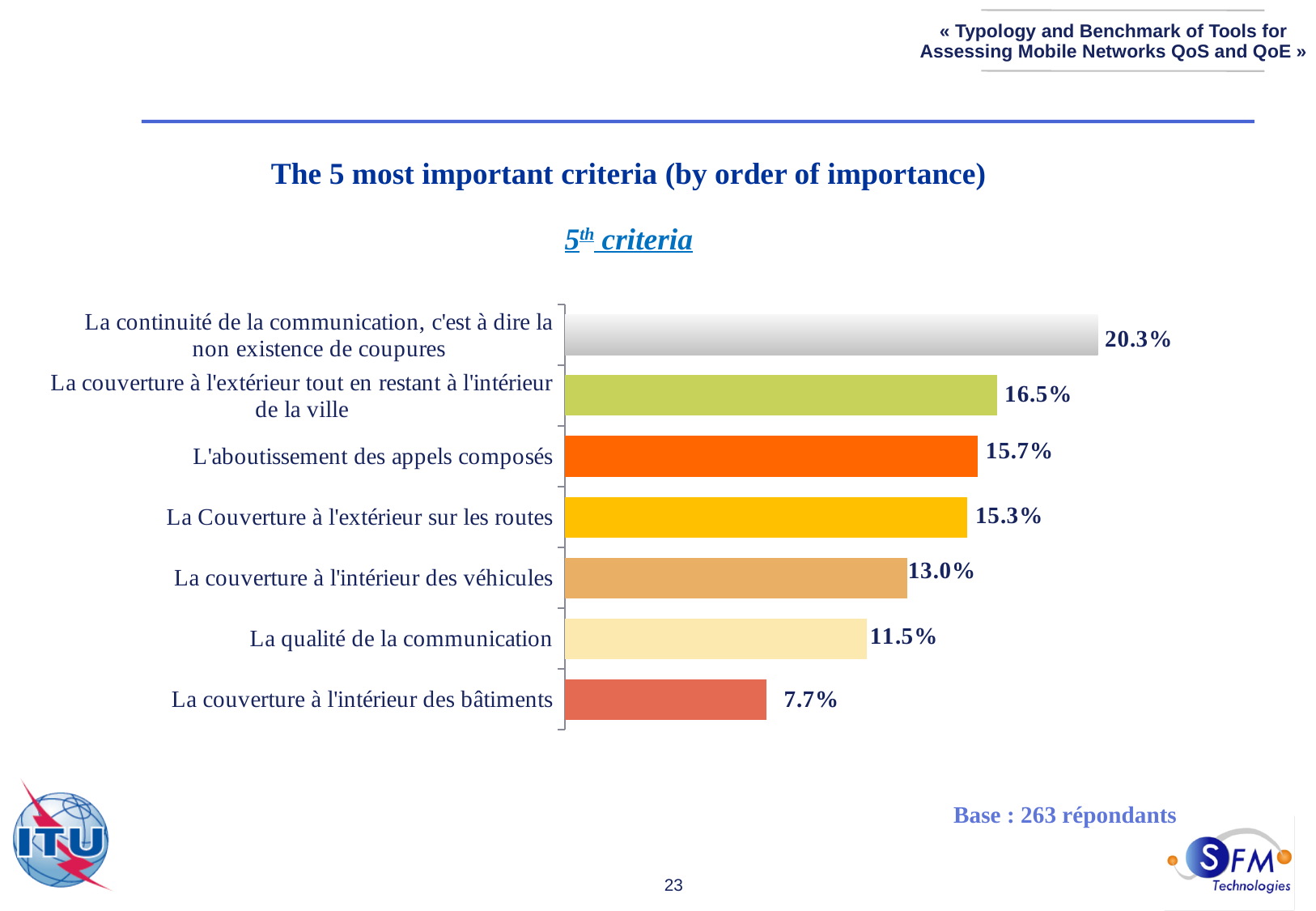
How many respondents form the base of the chart, according to the note on the slide? 263 What is the value for "La qualité de la communication"? 11.5% What is the difference between the values for "La couverture à l'extérieur tout en restant à l'intérieur de la ville" and "La couverture à l'intérieur des bâtiments"? 8.8% Which category has the highest value? La continuité de la communication, c'est à dire la non existence de coupures Which category has the lowest value? La couverture à l'intérieur des bâtiments What is the value for "La couverture à l'intérieur des véhicules"? 13.0% What is the difference between the values for "L'aboutissement des appels composés" and "La Couverture à l'extérieur sur les routes"? 0.4% Which is larger: the value for "La couverture à l'intérieur des véhicules" or "La qualité de la communication"? La couverture à l'intérieur des véhicules What is the subtitle shown directly above the chart? 5th criteria What kind of chart is shown on the slide? Bar chart How many categories are shown in the chart? 7 What is the value for "La continuité de la communication, c'est à dire la non existence de coupures"? 20.3%